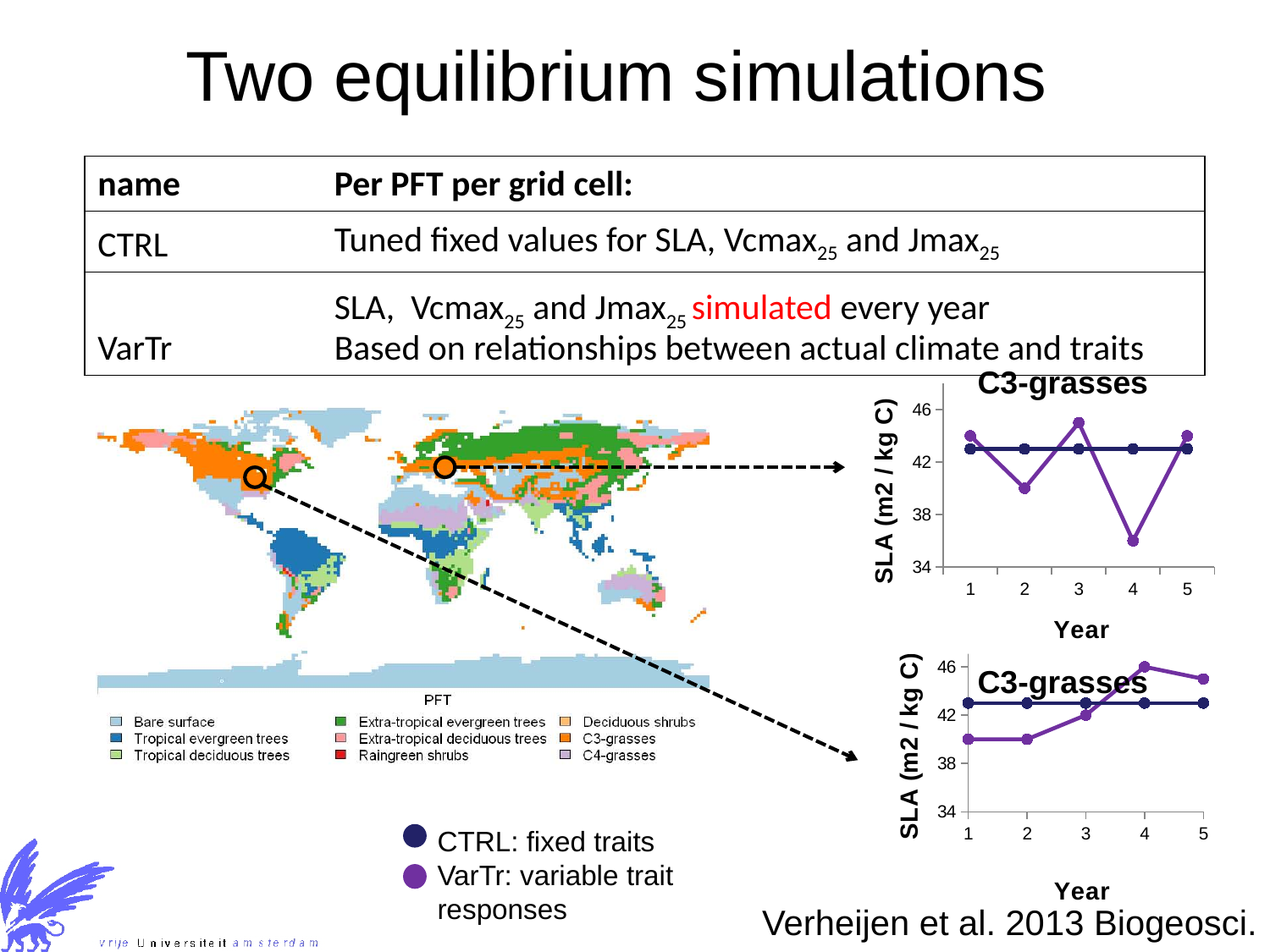
In the top-right C3-grasses chart, which series has the larger value in year 4, CTRL or VarTr? CTRL In the top-right C3-grasses chart, in which year is the VarTr series highest? 3 In the bottom-right C3-grasses chart, is the VarTr value for year 2 greater or less than 42? less In the top-right C3-grasses chart, in which year is the VarTr series lowest? 4 How many series does the legend list for the C3-grasses charts? 2 In the bottom-right C3-grasses chart, which series has the larger value in year 1, CTRL or VarTr? CTRL In the bottom-right C3-grasses chart, does the VarTr series rise or fall from year 1 to year 4? rise In the top-right C3-grasses chart, is the VarTr value for year 3 greater or less than 42? greater What is the y-axis label of the top-right C3-grasses chart? SLA (m2 / kg C) In the top-right C3-grasses chart, is the VarTr value for year 4 greater or less than 38? less In the top-right C3-grasses chart, how many years are plotted along the x axis? 5 What kind of chart is the top-right chart titled C3-grasses? line chart